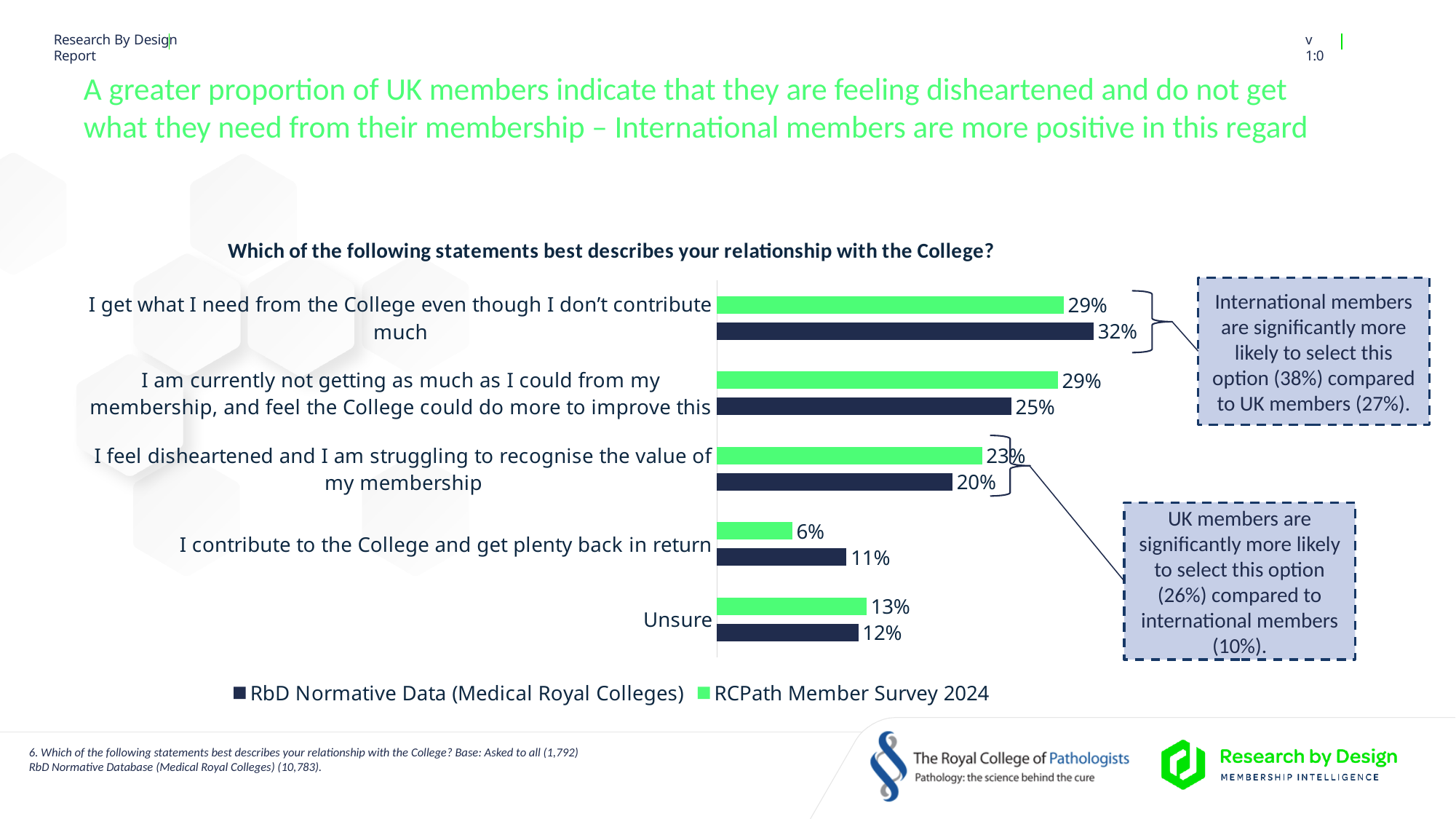
What percentage of RCPath Member Survey 2024 respondents selected "I contribute to the College and get plenty back in return"? 6% What is the RbD Normative Data value for "Unsure"? 12% How many statements (categories) are shown in the chart? 5 Which statement has the lowest RCPath Member Survey 2024 value? I contribute to the College and get plenty back in return What percentage of RCPath Member Survey 2024 respondents said "I feel disheartened and I am struggling to recognise the value of my membership"? 23% What type of chart is shown on the slide? Bar chart Which series is shown in green in the chart? RCPath Member Survey 2024 What is the RbD Normative Data value for "I get what I need from the College even though I don't contribute much"? 32% Which statement has the highest RbD Normative Data value? I get what I need from the College even though I don't contribute much What is the difference between the RbD Normative Data and RCPath Member Survey 2024 values for "I contribute to the College and get plenty back in return"? 5% For "I am currently not getting as much as I could from my membership, and feel the College could do more to improve this", which series has the larger value: RbD Normative Data or RCPath Member Survey 2024? RCPath Member Survey 2024 How many series does the chart legend list? 2